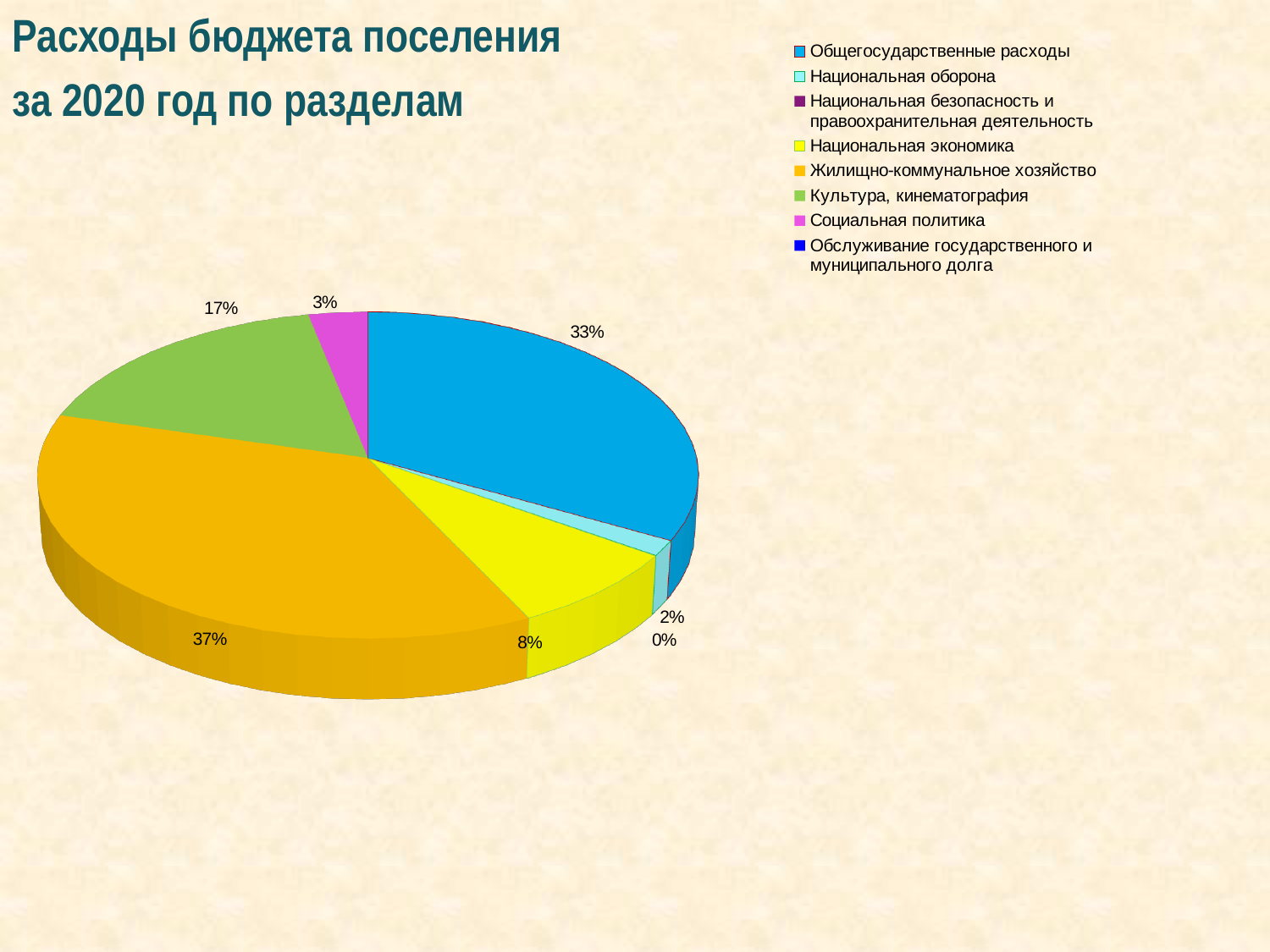
What share of the pie is Общегосударственные расходы? 33% Which section has the largest share of the pie? Жилищно-коммунальное хозяйство What is the title of the chart? Расходы бюджета поселения за 2020 год по разделам What share of the pie is Жилищно-коммунальное хозяйство? 37% What share of the pie is Социальная политика? 3% What share of the pie is Национальная экономика? 8% What share of the pie is Национальная оборона? 2% Which has the larger share: Культура, кинематография or Национальная экономика? Культура, кинематография What share of the pie is Культура, кинематография? 17% What kind of chart is shown on the slide? pie chart How many entries does the legend list? 8 What is the difference in percentage points between Жилищно-коммунальное хозяйство and Общегосударственные расходы? 4 percentage points